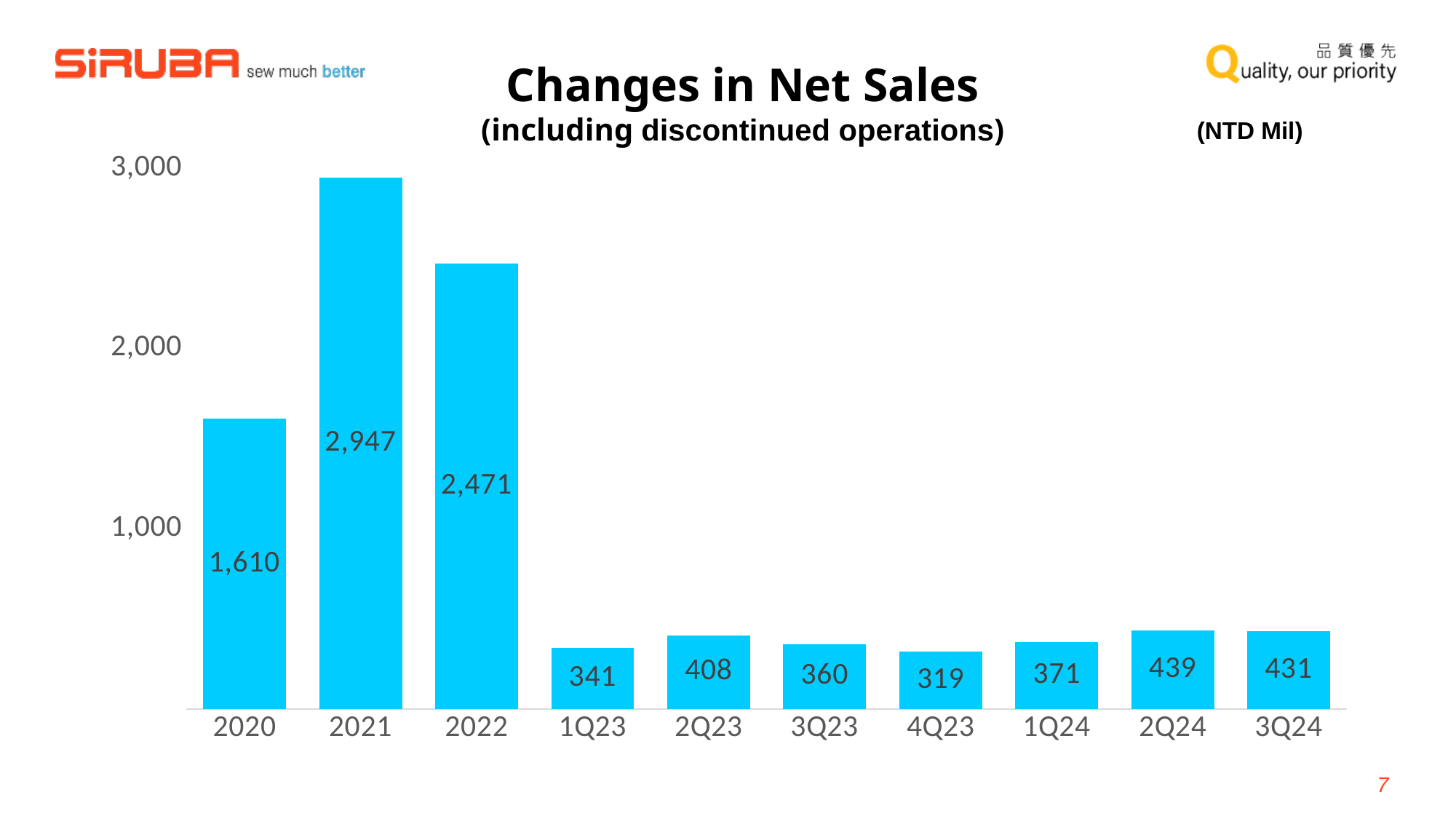
What is the difference in net sales between 2021 and 2022? 476 What is the net sales value for 2Q24? 439 How many categories are shown on the x axis? 10 Is the value for 2020 greater or less than 2,000? less Which is larger, the net sales for 1Q23 or 1Q24? 1Q24 Which category has the highest net sales? 2021 What is the net sales value for 2021? 2,947 What unit is stated for the values in the chart? NTD Mil Which category has the lowest net sales? 4Q23 What is the net sales value for 4Q23? 319 What is the difference in net sales between 2Q24 and 3Q24? 8 What kind of chart is shown on the slide? bar chart